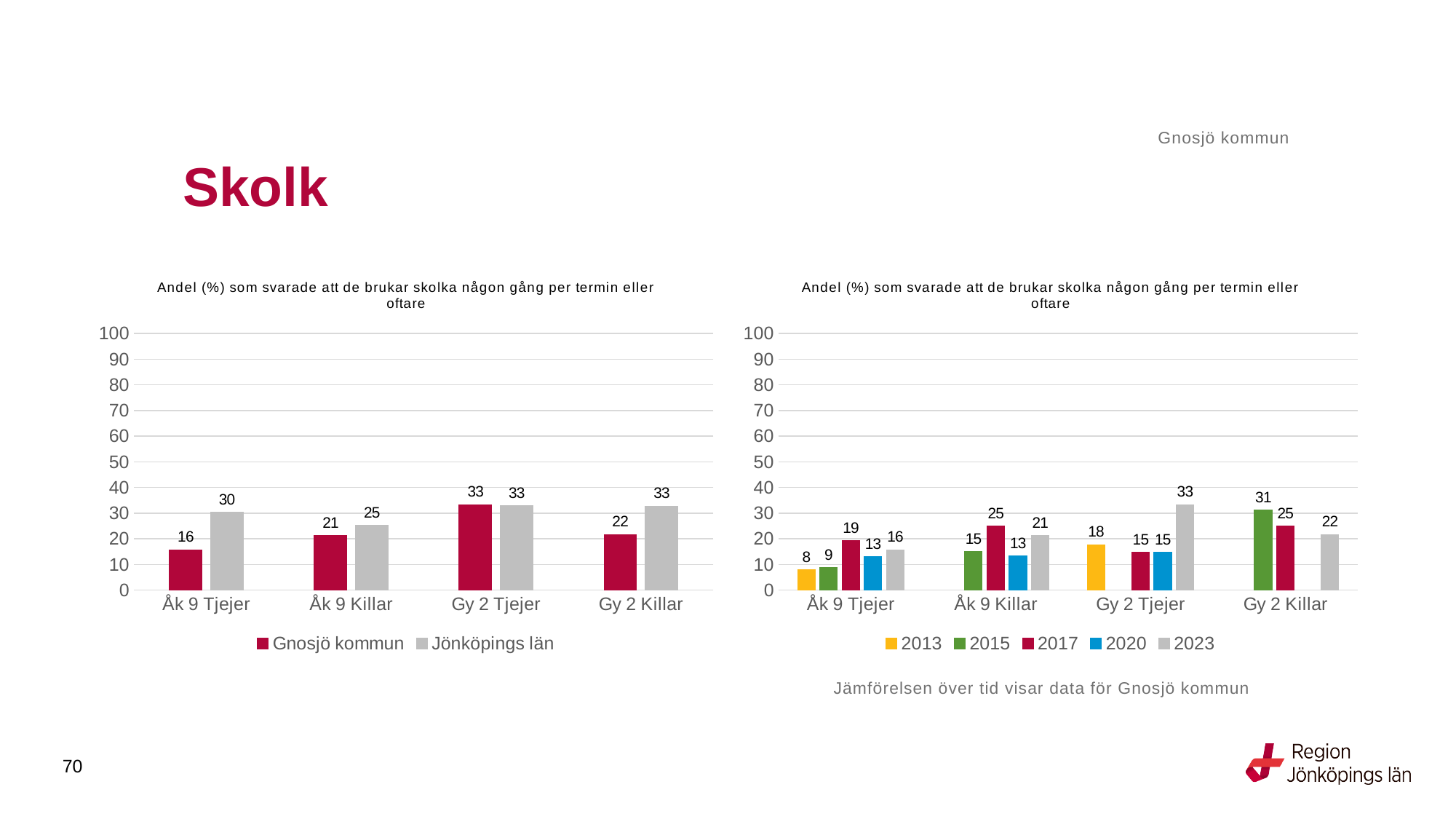
In the right chart, what is the value for 2013 for Gy 2 Tjejer? 18 What type of chart is the right chart? Bar chart In the right chart, what is the value for 2017 for Åk 9 Killar? 25 In the right chart, how many series does the legend list? 5 In the left chart, which is larger for Gy 2 Killar: Gnosjö kommun or Jönköpings län? Jönköpings län In the left chart, what is the value for Jönköpings län for Gy 2 Killar? 33 In the left chart, what is the value for Gnosjö kommun for Åk 9 Tjejer? 16 In the right chart, what is the difference between 2015 and 2023 for Gy 2 Killar? 9 In the left chart, which category has the lowest value for Gnosjö kommun? Åk 9 Tjejer In the left chart, what is the difference between Jönköpings län and Gnosjö kommun for Åk 9 Tjejer? 14 In the right chart, which year has the highest value for Gy 2 Tjejer? 2023 In the left chart, how many series does the legend list? 2